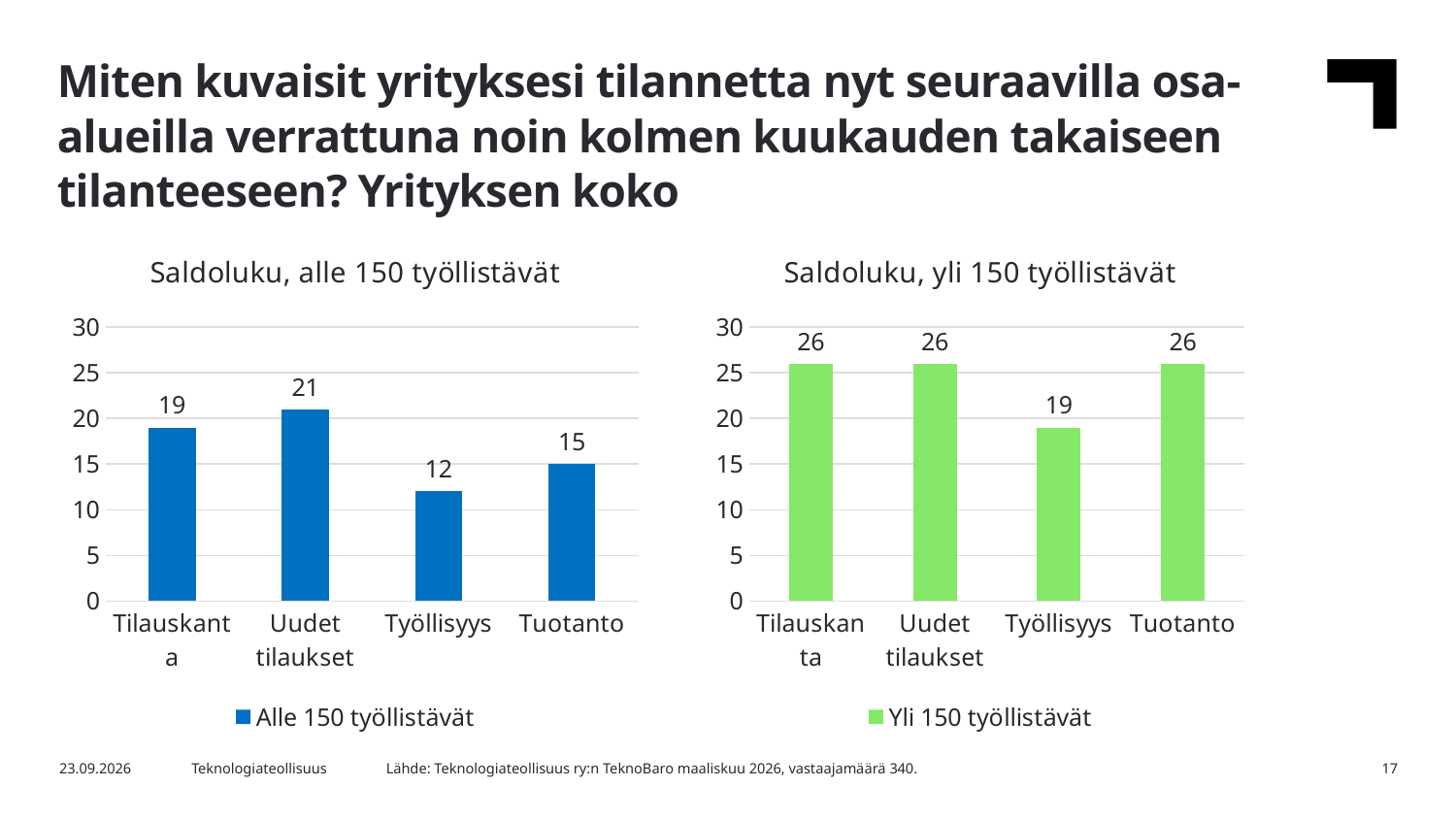
In the chart titled 'Saldoluku, alle 150 työllistävät', which category has the lowest value? Työllisyys In the chart titled 'Saldoluku, yli 150 työllistävät', is the value for Tilauskanta greater or less than 20? greater In the chart titled 'Saldoluku, yli 150 työllistävät', what is the value for Työllisyys? 19 In the chart titled 'Saldoluku, alle 150 työllistävät', which is larger, the value for Tilauskanta or the value for Tuotanto? Tilauskanta In the chart titled 'Saldoluku, alle 150 työllistävät', what is the difference between the values for Uudet tilaukset and Työllisyys? 9 What is the legend entry of the chart titled 'Saldoluku, yli 150 työllistävät'? Yli 150 työllistävät In the chart titled 'Saldoluku, yli 150 työllistävät', which category has the lowest value? Työllisyys In the chart titled 'Saldoluku, yli 150 työllistävät', what is the difference between the values for Tuotanto and Työllisyys? 7 In the chart titled 'Saldoluku, alle 150 työllistävät', what is the value for Uudet tilaukset? 21 In the chart titled 'Saldoluku, alle 150 työllistävät', which category has the highest value? Uudet tilaukset What kind of chart is the chart titled 'Saldoluku, yli 150 työllistävät'? Bar chart How many categories are shown in the chart titled 'Saldoluku, alle 150 työllistävät'? 4